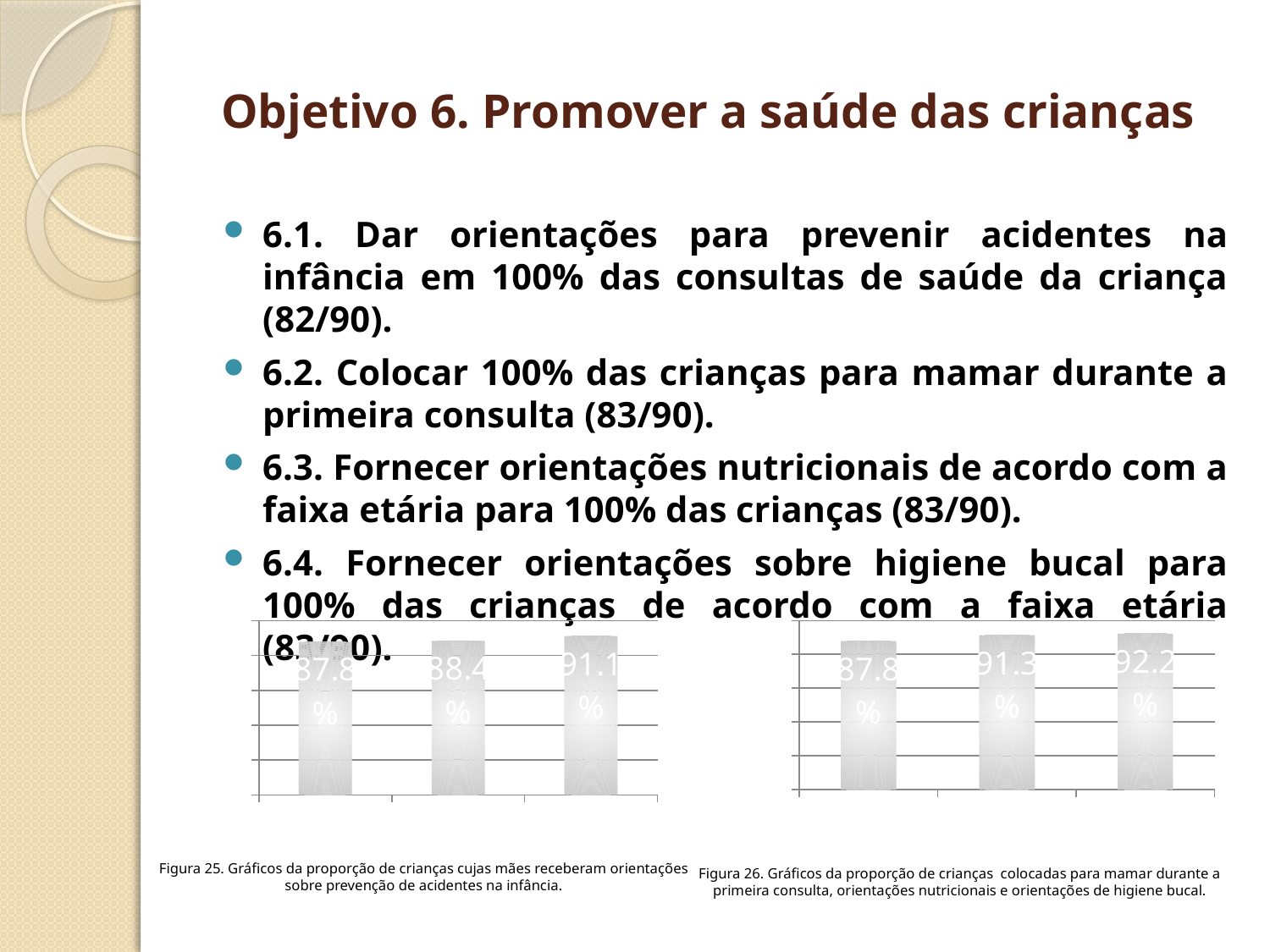
In the right chart (Figura 26), what is the difference between the rightmost bar and the leftmost bar? 4.4 percentage points What kind of chart is the left chart (Figura 25)? bar chart What kind of chart is the right chart (Figura 26)? bar chart How many bars does the left chart (Figura 25) show? 3 In the left chart (Figura 25), which bar has the lowest value? the leftmost bar (87.8%) In the left chart (Figura 25), do the values rise or fall from left to right? rise In the right chart (Figura 26), what is the value of the middle bar? 91.3% In the left chart (Figura 25), what is the value of the middle bar? 88.4% In the right chart (Figura 26), which bar has the highest value? the rightmost bar (92.2%) In the left chart (Figura 25), what is the value of the rightmost bar? 91.1% In the left chart (Figura 25), what is the difference between the rightmost bar and the leftmost bar? 3.3 percentage points How many bars does the right chart (Figura 26) show? 3